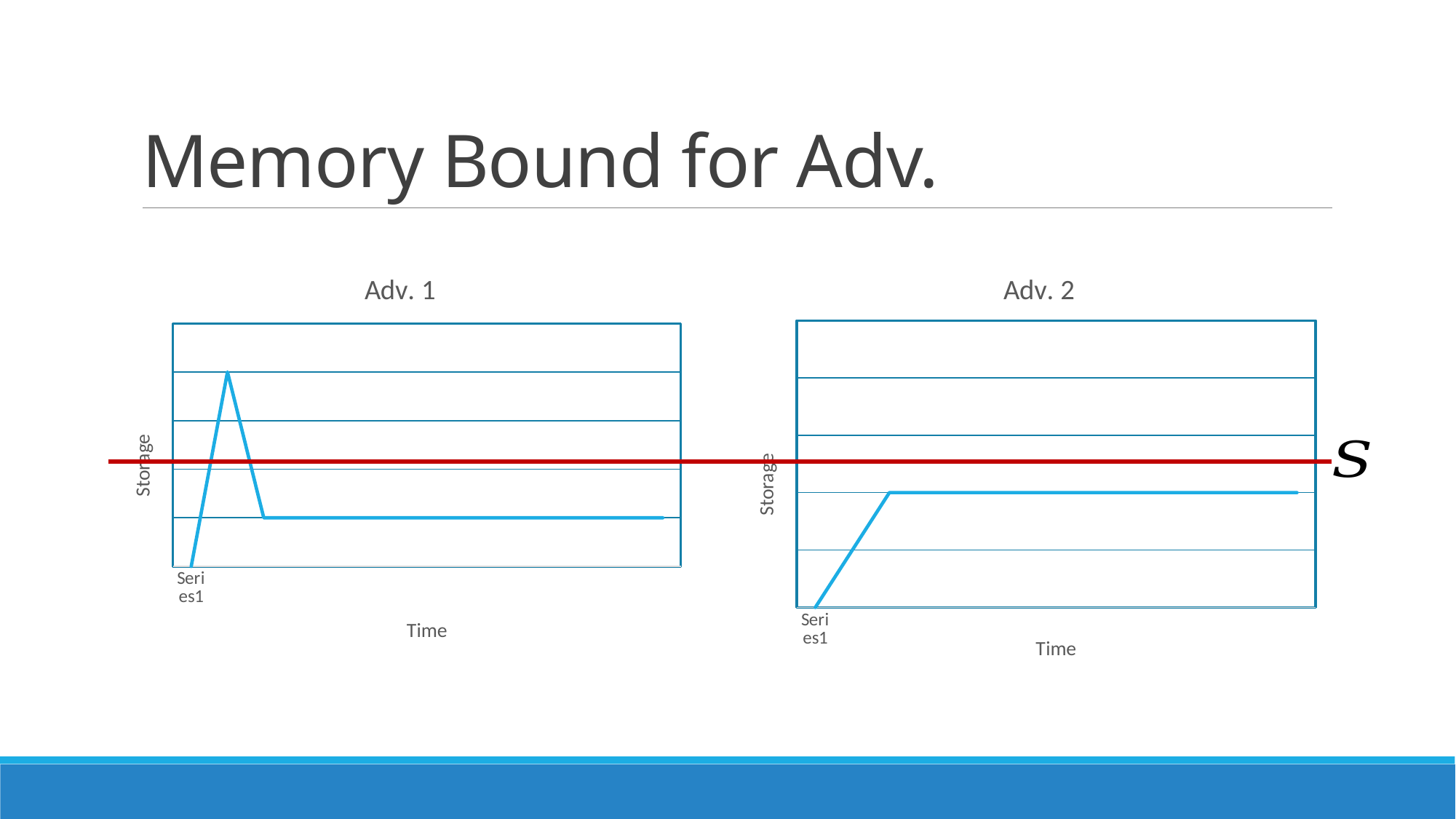
In the Adv. 1 chart, is the flat part of the line above or below the red line S? below Which chart's line reaches a higher peak, Adv. 1 or Adv. 2? Adv. 1 In the Adv. 1 chart, what is the title of the vertical axis? Storage What kind of chart is the Adv. 2 chart? line chart In the Adv. 1 chart, does the plotted line ever go above the red line labelled S? yes In the Adv. 2 chart, how does the line behave along the Time axis? rises, then stays flat In the Adv. 1 chart, how does the line behave along the Time axis? rises sharply to a peak, then falls and stays flat In the Adv. 2 chart, what is the title of the horizontal axis? Time What kind of chart is the Adv. 1 chart? line chart